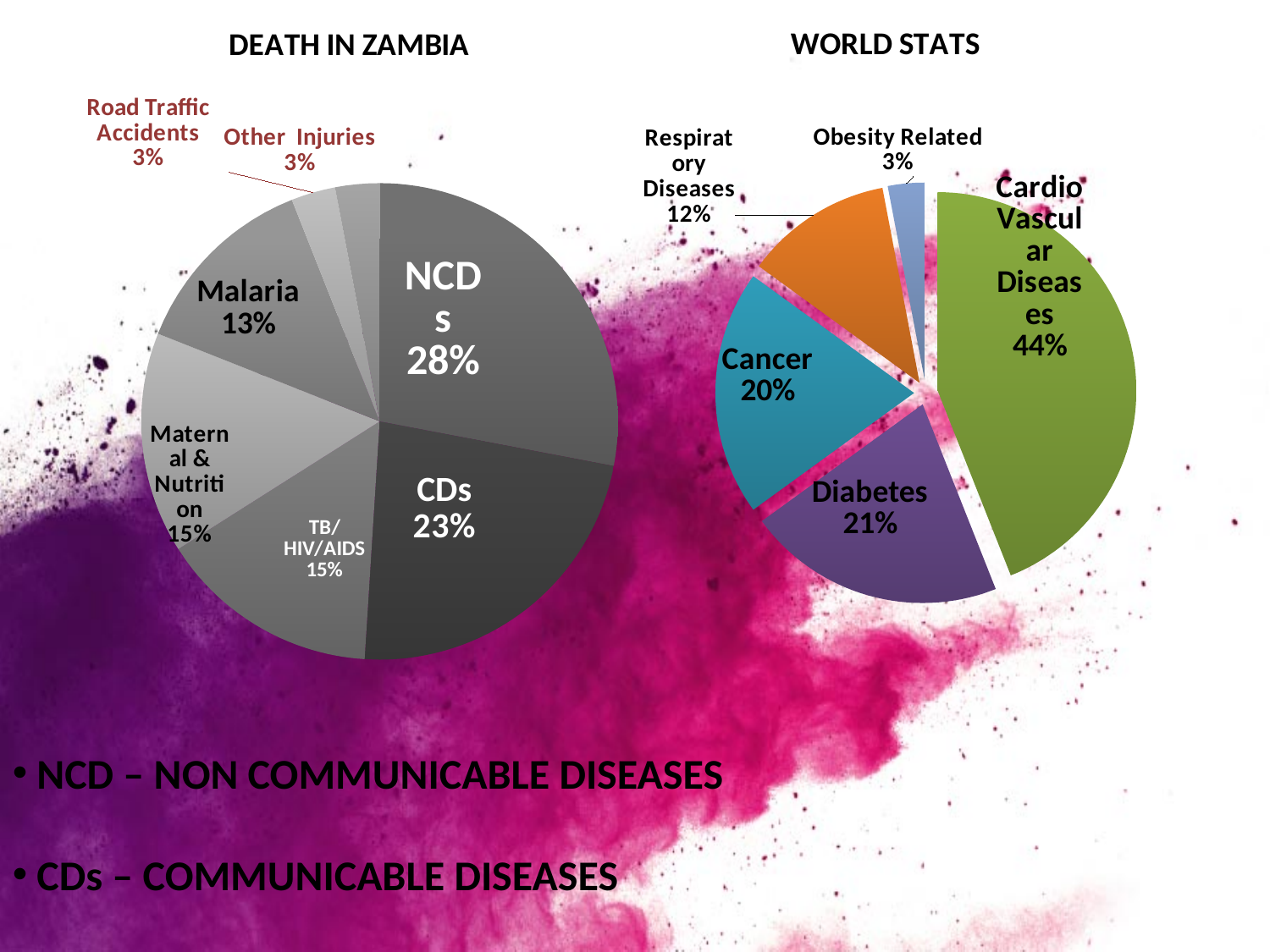
In the DEATH IN ZAMBIA chart, which category has the largest share? NCDs In the DEATH IN ZAMBIA chart, which is larger, Malaria or Maternal & Nutrition? Maternal & Nutrition In the DEATH IN ZAMBIA chart, what percentage is shown for Malaria? 13% In the WORLD STATS chart, what is the difference between Diabetes and Cancer? 1% In the WORLD STATS chart, what colour is the Cancer slice? Teal/blue What type of chart is the WORLD STATS chart? Pie chart In the WORLD STATS chart, which category has the smallest share? Obesity Related In the DEATH IN ZAMBIA chart, what is the difference between the NCDs share and the CDs share? 5% In the DEATH IN ZAMBIA chart, what share of deaths is attributed to NCDs? 28% In the WORLD STATS chart, how many categories are shown? 5 In the WORLD STATS chart, what percentage is shown for Cardio Vascular Diseases? 44% In the DEATH IN ZAMBIA chart, how many categories are shown? 7